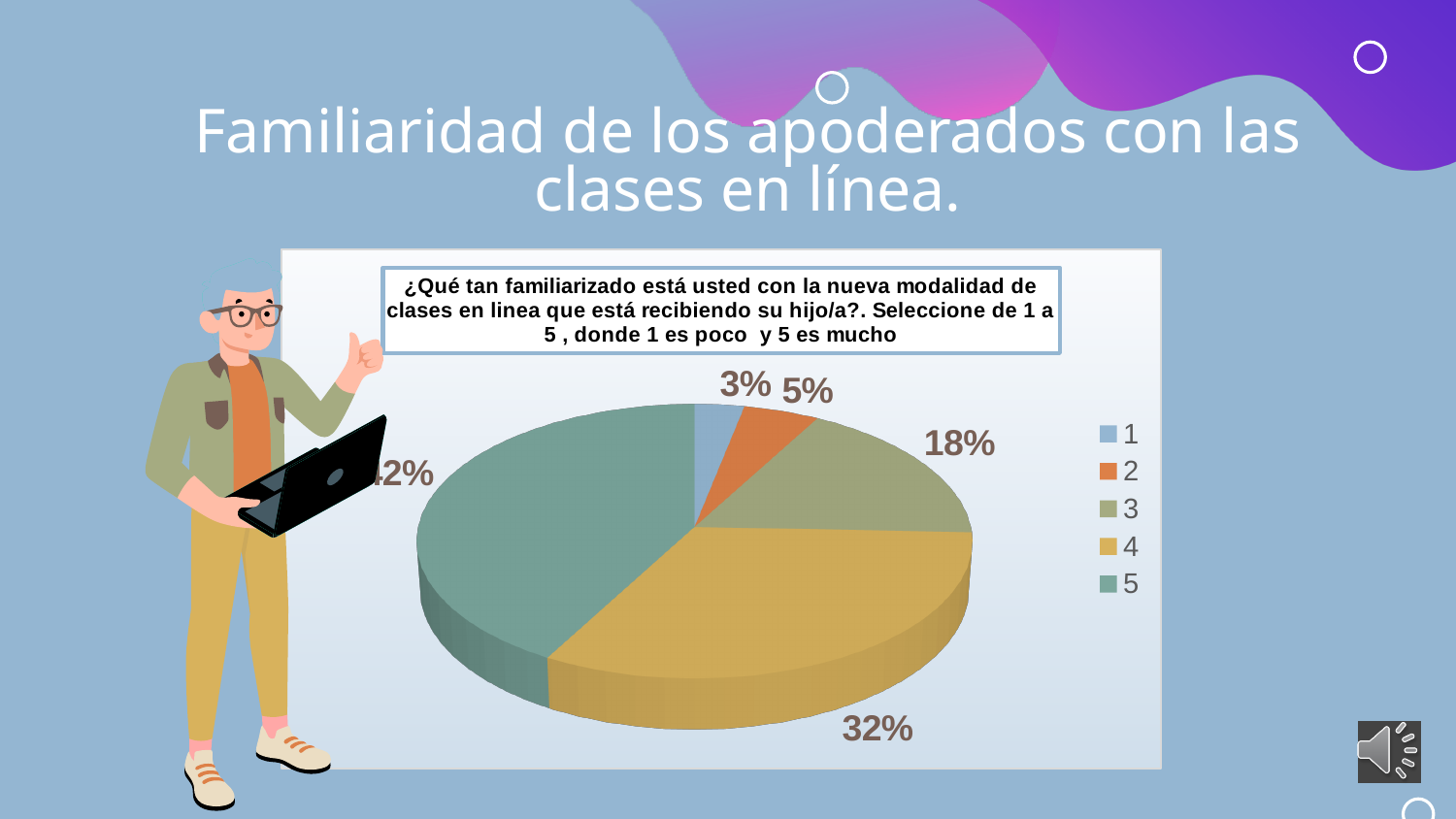
What percentage of the pie corresponds to category 2? 5% What is the difference in percentage points between category 4 and category 3? 14% How many categories does the legend of the pie chart list? 5 What kind of chart is shown on the slide? pie chart What is the difference in percentage points between category 3 and category 1? 15% Which slice is larger, category 3 or category 2? 3 What share of the pie does category 4 represent? 32% What percentage of the pie corresponds to category 1? 3% Which category has the smallest slice of the pie? 1 What percentage of the pie corresponds to category 3? 18% According to the chart's question text, what does a rating of 5 mean on the scale? mucho Which category has the largest slice of the pie? 5